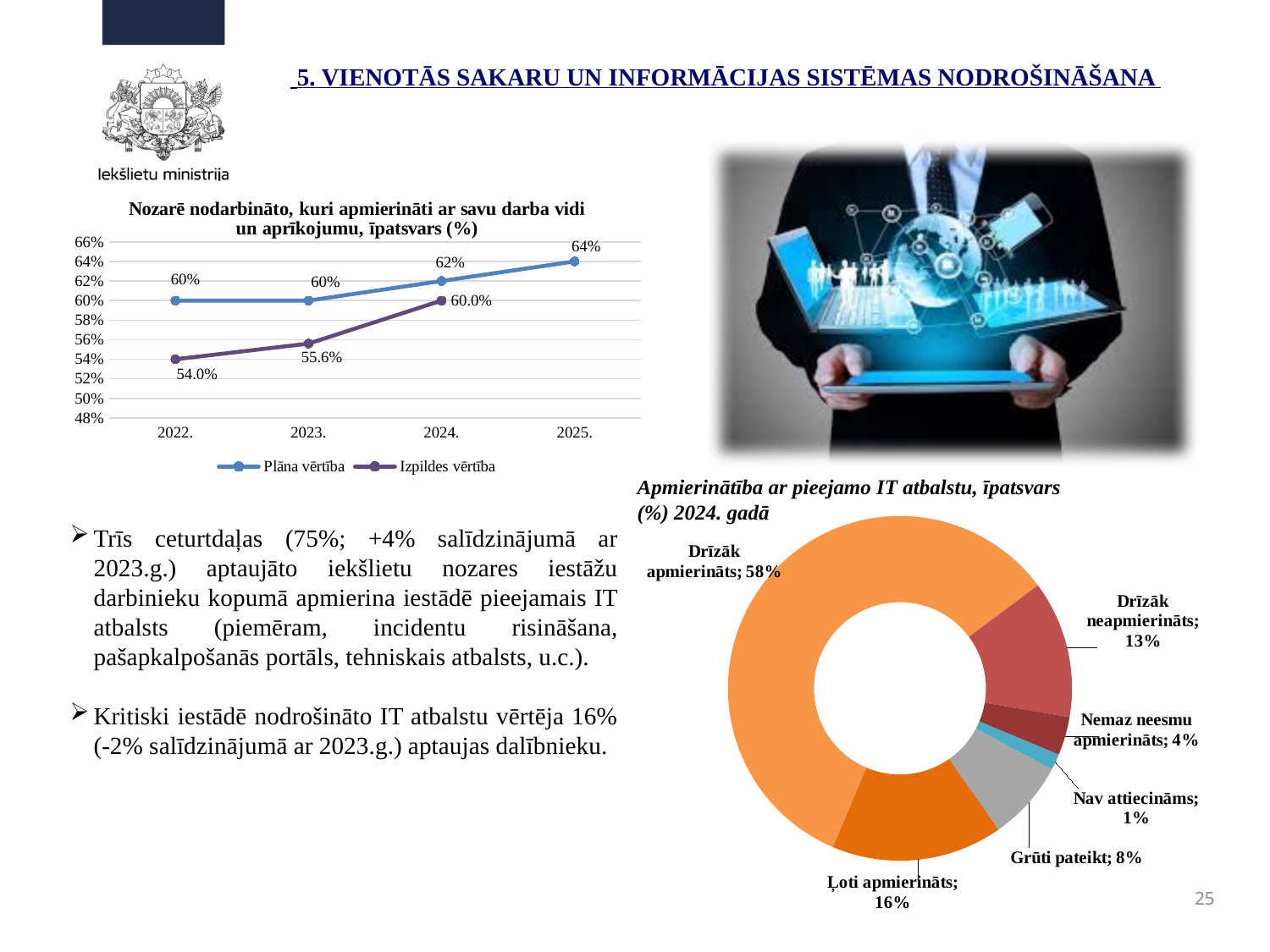
In the doughnut chart 'Apmierinātība ar pieejamo IT atbalstu, īpatsvars (%) 2024. gadā', what is the difference between 'Ļoti apmierināts' and 'Grūti pateikt'? 8% In the line chart 'Nozarē nodarbināto, kuri apmierināti ar savu darba vidi un aprīkojumu, īpatsvars (%)', which is larger in 2023., the Plāna vērtība or the Izpildes vērtība? Plāna vērtība In the line chart 'Nozarē nodarbināto, kuri apmierināti ar savu darba vidi un aprīkojumu, īpatsvars (%)', what is the Plāna vērtība for 2025.? 64% In the doughnut chart 'Apmierinātība ar pieejamo IT atbalstu, īpatsvars (%) 2024. gadā', what share is 'Drīzāk apmierināts'? 58% What kind of chart is 'Apmierinātība ar pieejamo IT atbalstu, īpatsvars (%) 2024. gadā'? doughnut chart In the line chart 'Nozarē nodarbināto, kuri apmierināti ar savu darba vidi un aprīkojumu, īpatsvars (%)', how many series does the legend list? 2 In the line chart 'Nozarē nodarbināto, kuri apmierināti ar savu darba vidi un aprīkojumu, īpatsvars (%)', what is the Izpildes vērtība for 2023.? 55.6% In the doughnut chart 'Apmierinātība ar pieejamo IT atbalstu, īpatsvars (%) 2024. gadā', which category has the smallest share? Nav attiecināms In the line chart 'Nozarē nodarbināto, kuri apmierināti ar savu darba vidi un aprīkojumu, īpatsvars (%)', what is the Izpildes vērtība for 2022.? 54.0% In the line chart 'Nozarē nodarbināto, kuri apmierināti ar savu darba vidi un aprīkojumu, īpatsvars (%)', does the Izpildes vērtība rise or fall from 2022. to 2024.? rise In the line chart 'Nozarē nodarbināto, kuri apmierināti ar savu darba vidi un aprīkojumu, īpatsvars (%)', what is the difference between the Plāna vērtība and the Izpildes vērtība in 2022.? 6% In the doughnut chart 'Apmierinātība ar pieejamo IT atbalstu, īpatsvars (%) 2024. gadā', how many categories are shown? 6